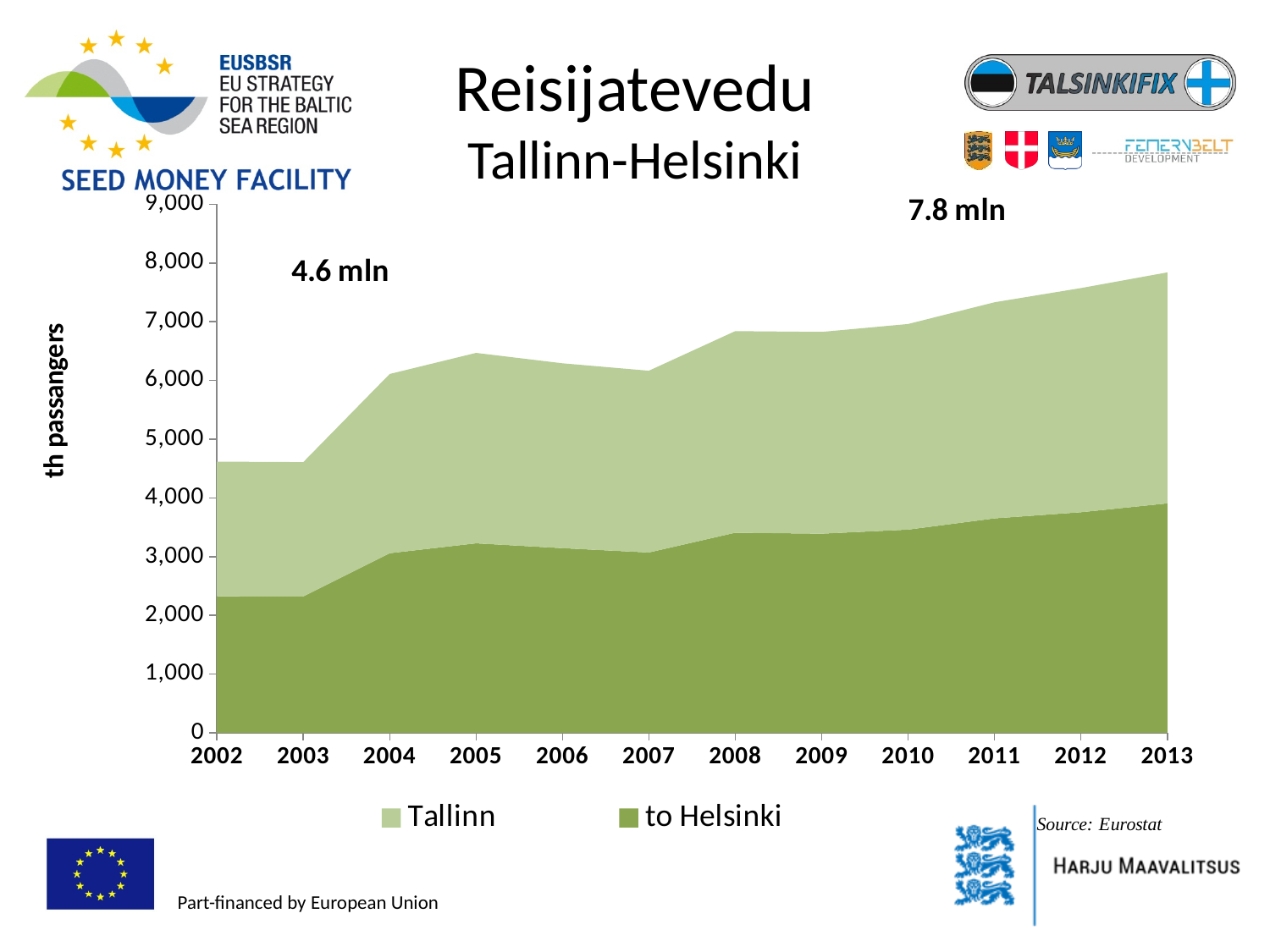
Do total passenger numbers generally rise or fall from 2002 to 2013? Rise Is the total stacked value for 2013 greater or less than 7,000? greater Is the total stacked value for 2002 greater or less than 5,000? less What kind of chart is shown on the slide? Stacked area chart In which year is the total stacked value highest? 2013 What annotated total is printed near the end of the series (around 2013)? 7.8 mln What annotated total is printed near the start of the series (around 2002)? 4.6 mln How many years are shown on the x axis? 12 Which two series are listed in the legend? Tallinn and to Helsinki What is the label on the vertical axis? th passangers How many series does the legend list? 2